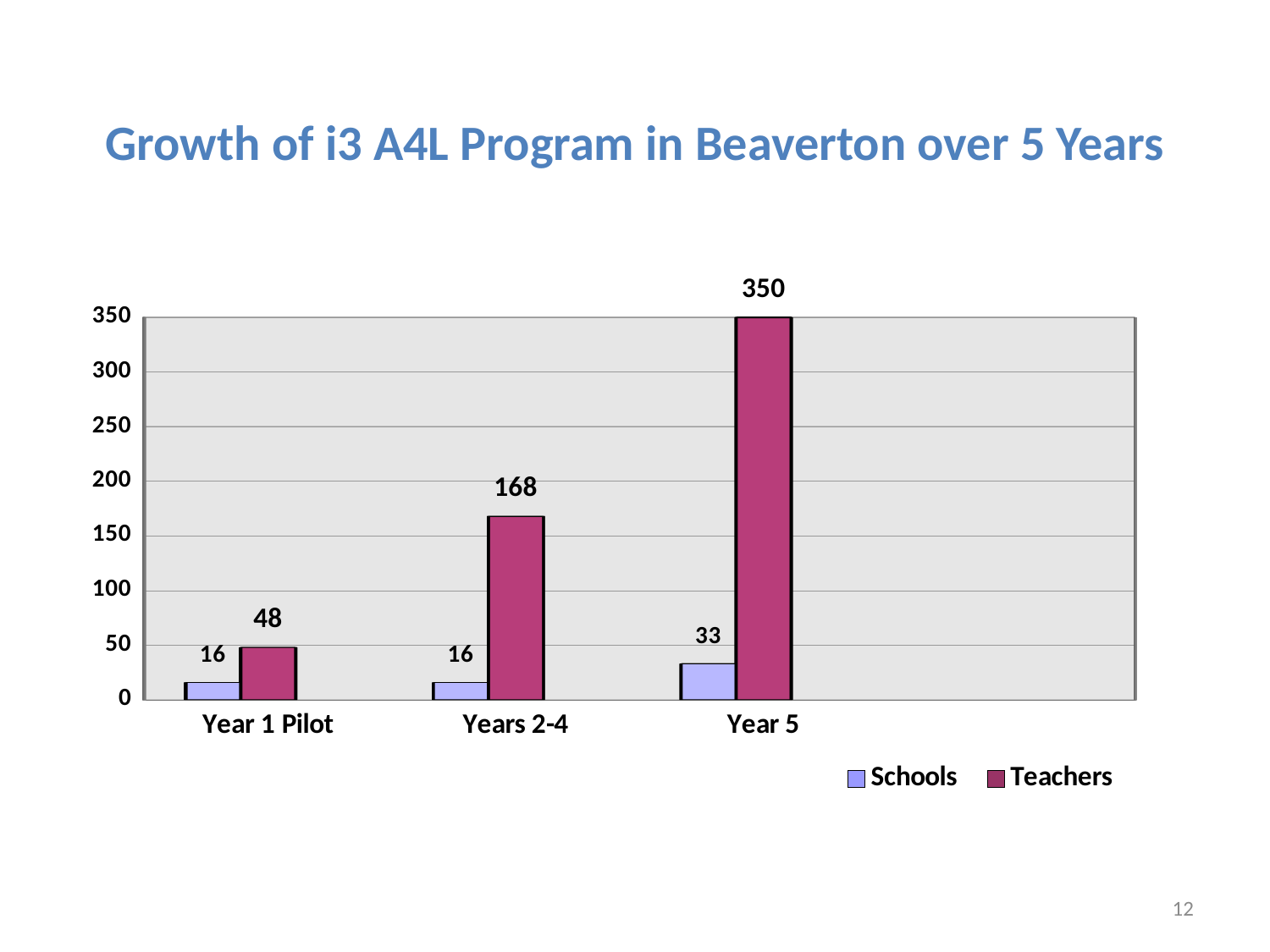
What is the number of Schools in Years 2-4? 16 What is the difference between the number of Teachers in Year 5 and in Years 2-4? 182 What is the number of Teachers in the Year 1 Pilot? 48 Which is larger: the number of Teachers in Years 2-4 or the number of Schools in Year 5? Teachers in Years 2-4 What is the number of Teachers in Year 5? 350 Is the number of Teachers in Years 2-4 greater or less than 150? greater Which category has the highest number of Teachers? Year 5 Which category has the lowest number of Teachers? Year 1 Pilot What kind of chart is shown on the slide? bar chart What is the difference between the number of Schools in Year 5 and in the Year 1 Pilot? 17 How many series does the legend list? 2 How many categories are shown on the x axis? 3